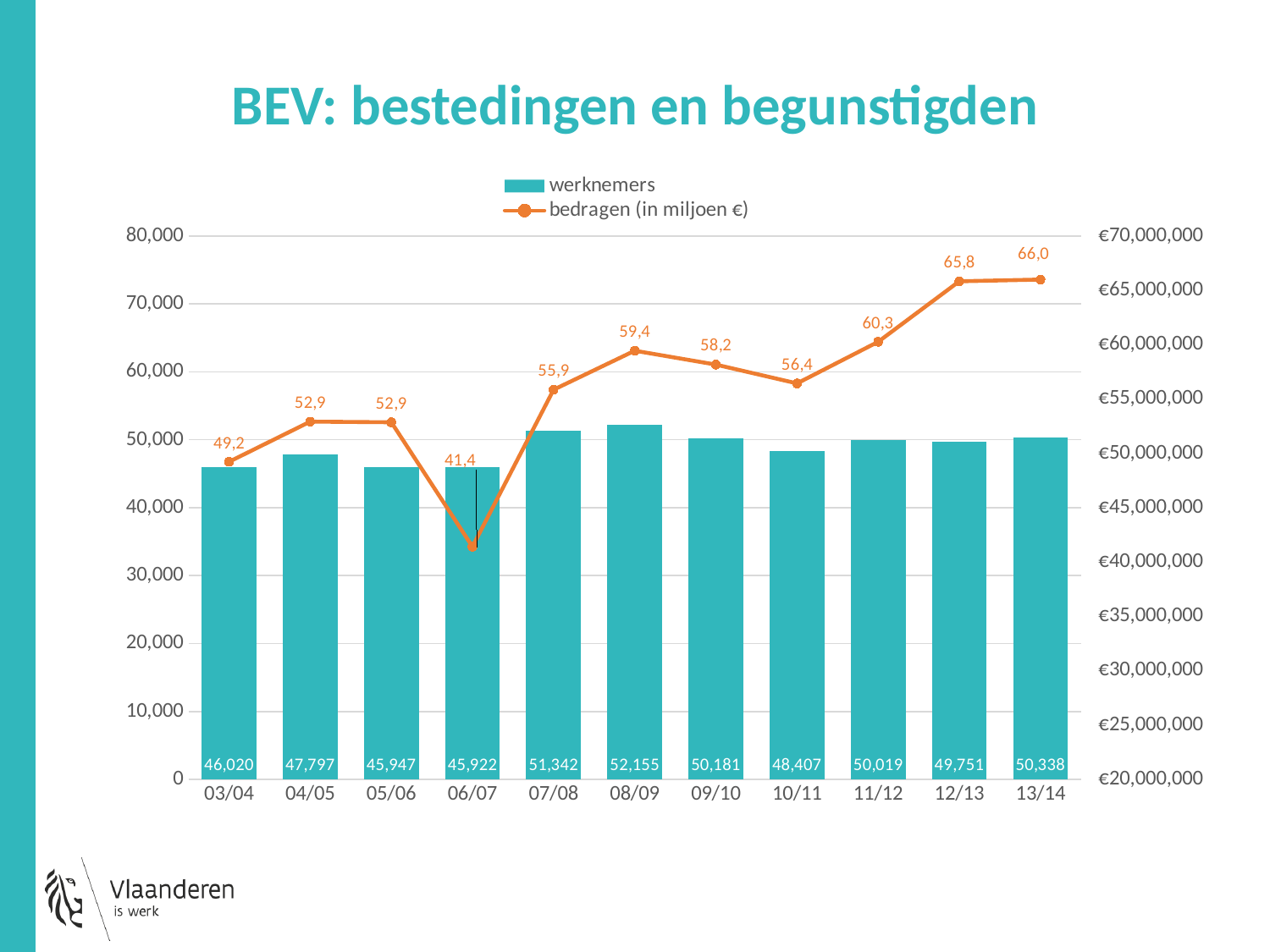
How many series does the legend list? 2 What is the title of the chart? BEV: bestedingen en begunstigden What is the bedragen (in miljoen €) value for 06/07? 41,4 What is the difference in bedragen (in miljoen €) between 13/14 and 03/04? 16,8 Which year has the highest bedragen (in miljoen €) value? 13/14 What is the difference in werknemers between 08/09 and 06/07? 6,233 Which year has the highest werknemers value? 08/09 What is the werknemers value for 13/14? 50,338 How many years are shown on the x axis? 11 Which year has a larger werknemers value, 04/05 or 10/11? 10/11 Which year has the lowest bedragen (in miljoen €) value? 06/07 What is the werknemers value for 08/09? 52,155